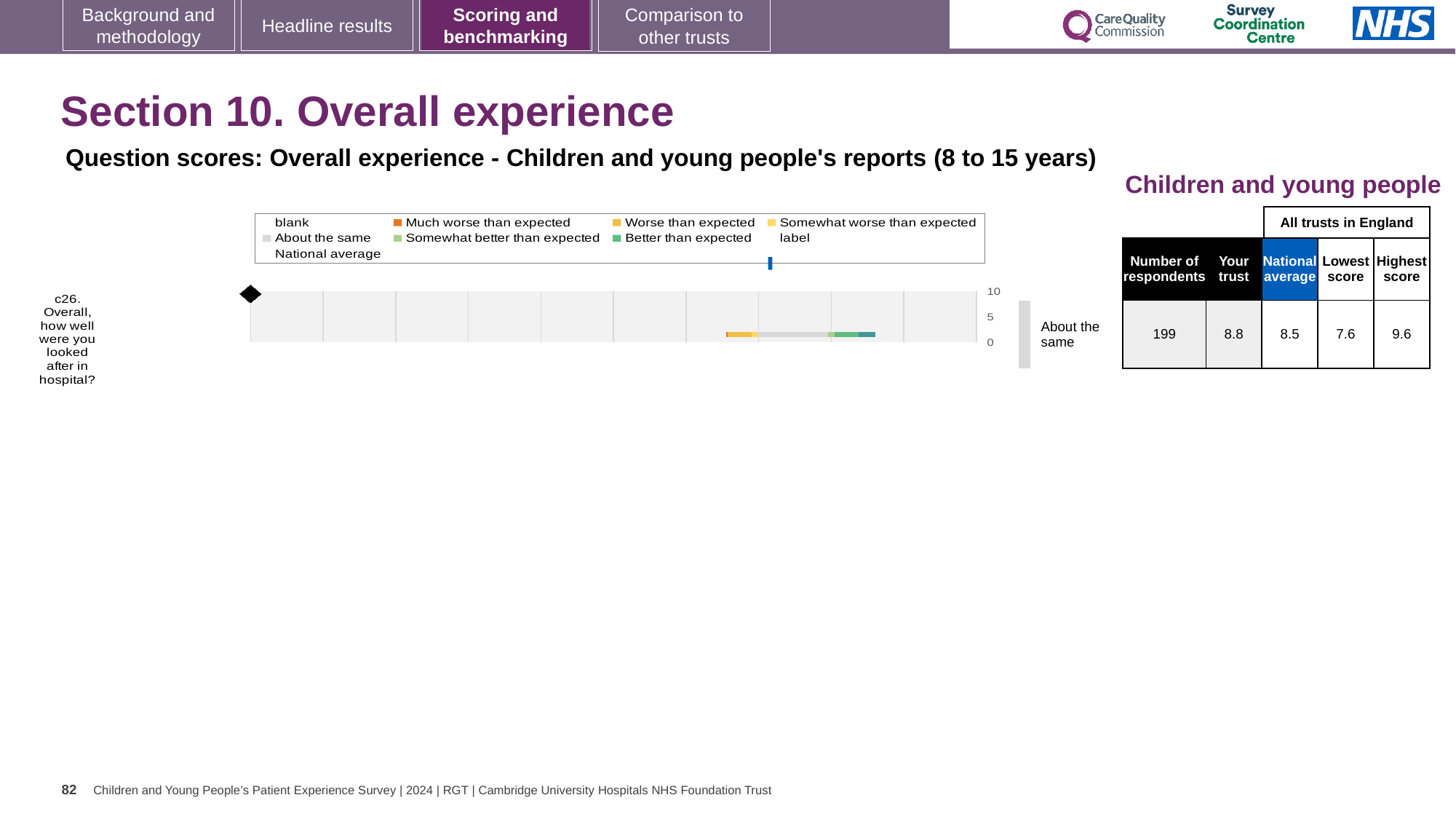
What kind of chart is shown on the slide? Bar chart What is the difference between the trust's score and the national average for question c26? 0.3 How many respondents answered question c26? 199 What is the score for 'Your trust' for question c26 (Overall, how well were you looked after in hospital?)? 8.8 What is the national average score for question c26? 8.5 How is the trust's result for question c26 categorised relative to other trusts? About the same What is the highest score among all trusts in England for question c26? 9.6 Is the trust's score for question c26 greater or less than 5? greater How many questions are plotted in the chart? 1 What is the lowest score among all trusts in England for question c26? 7.6 Which is higher for question c26: the trust's score or the national average? Your trust What is the difference between the highest and lowest scores among all trusts in England for question c26? 2.0